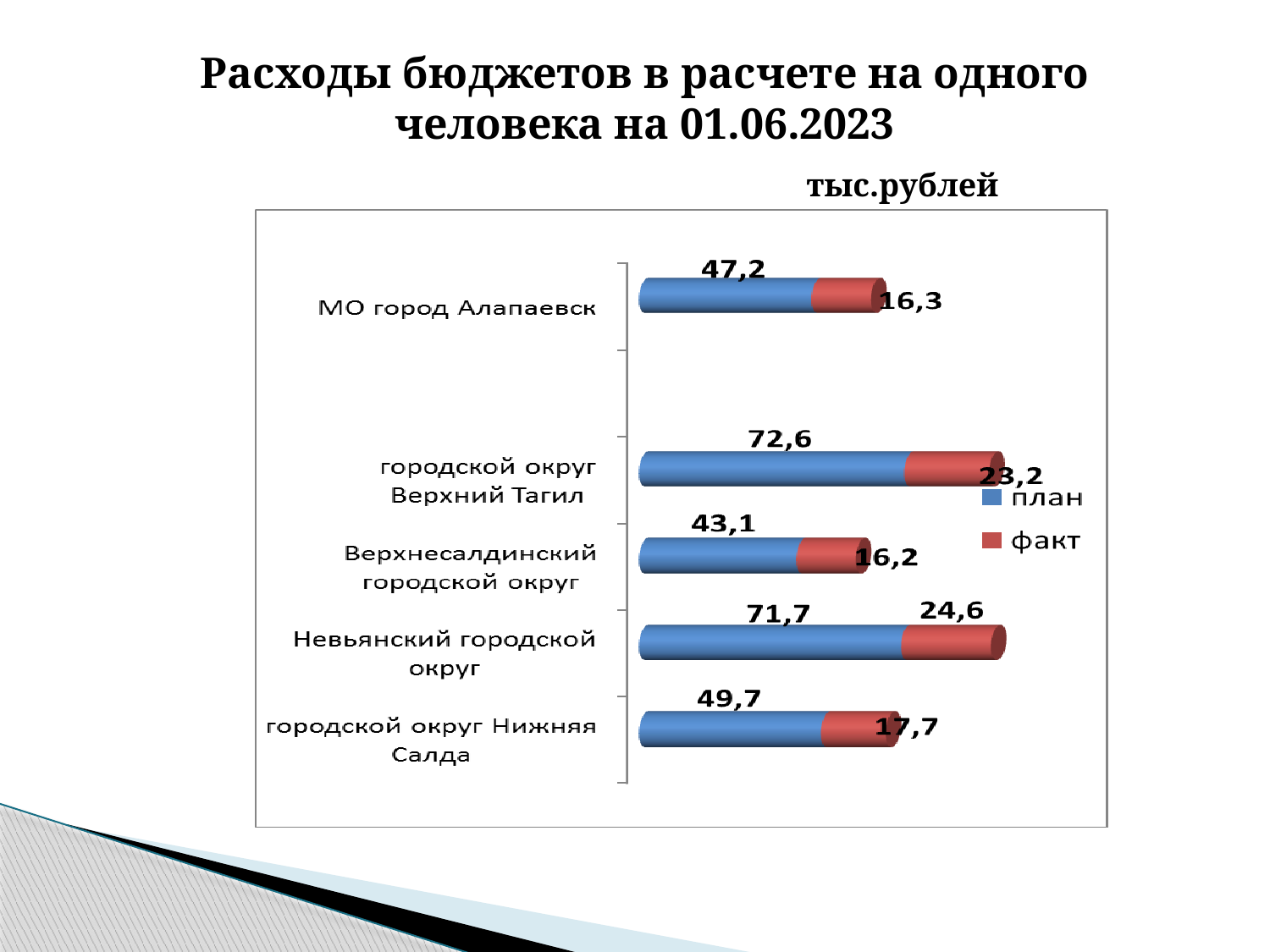
What is the total of the stacked bar for Верхнесалдинский городской округ? 59,3 What is the план value for МО город Алапаевск? 47,2 How many series does the legend list? 2 What is the план value for городской округ Нижняя Салда? 49,7 What kind of chart is shown on the slide? bar chart Which category has the highest факт value? Невьянский городской округ What is the факт value for Невьянский городской округ? 24,6 How many categories are shown in the chart? 5 Which category has the lowest план value? Верхнесалдинский городской округ Which is larger: the факт value for МО город Алапаевск or the факт value for городской округ Нижняя Салда? городской округ Нижняя Салда Which category has the highest план value? городской округ Верхний Тагил What is the difference between the план and факт values for городской округ Верхний Тагил? 49,4